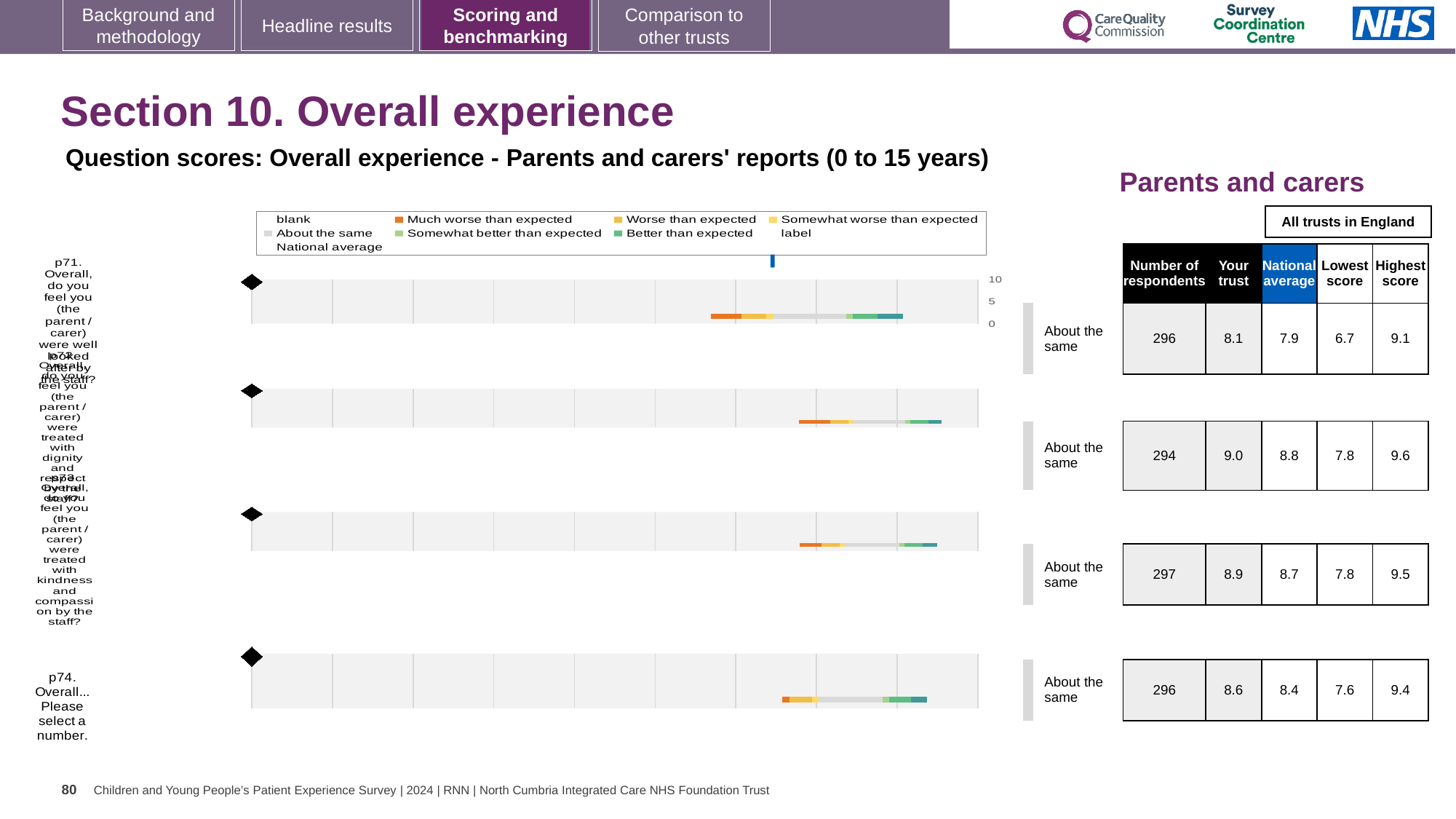
How many question rows (p71 to p74) are plotted in the chart? 4 Which question row has the highest 'Your trust' score in the table? p72 (second row), 9.0 For the second row (p72), what is the difference between the 'Your trust' score and the National average? 0.2 How many respondents are listed for the third row (p73)? 297 What benchmark category is shown next to the chart for p71 (the first row)? About the same What kind of chart is used to show the question scores on this slide? bar chart In the table beside the chart, what is the 'Your trust' score for p74 (Overall... Please select a number)? 8.6 What is the Highest score listed for p74 (the last row)? 9.4 What colour does the legend use for 'Much worse than expected'? orange In the table beside the chart, what is the National average score for p71 (the first row)? 7.9 For the third row (p73), which is larger: the 'Your trust' score or the National average? Your trust Which question row has the lowest 'Your trust' score in the table? p71 (first row), 8.1